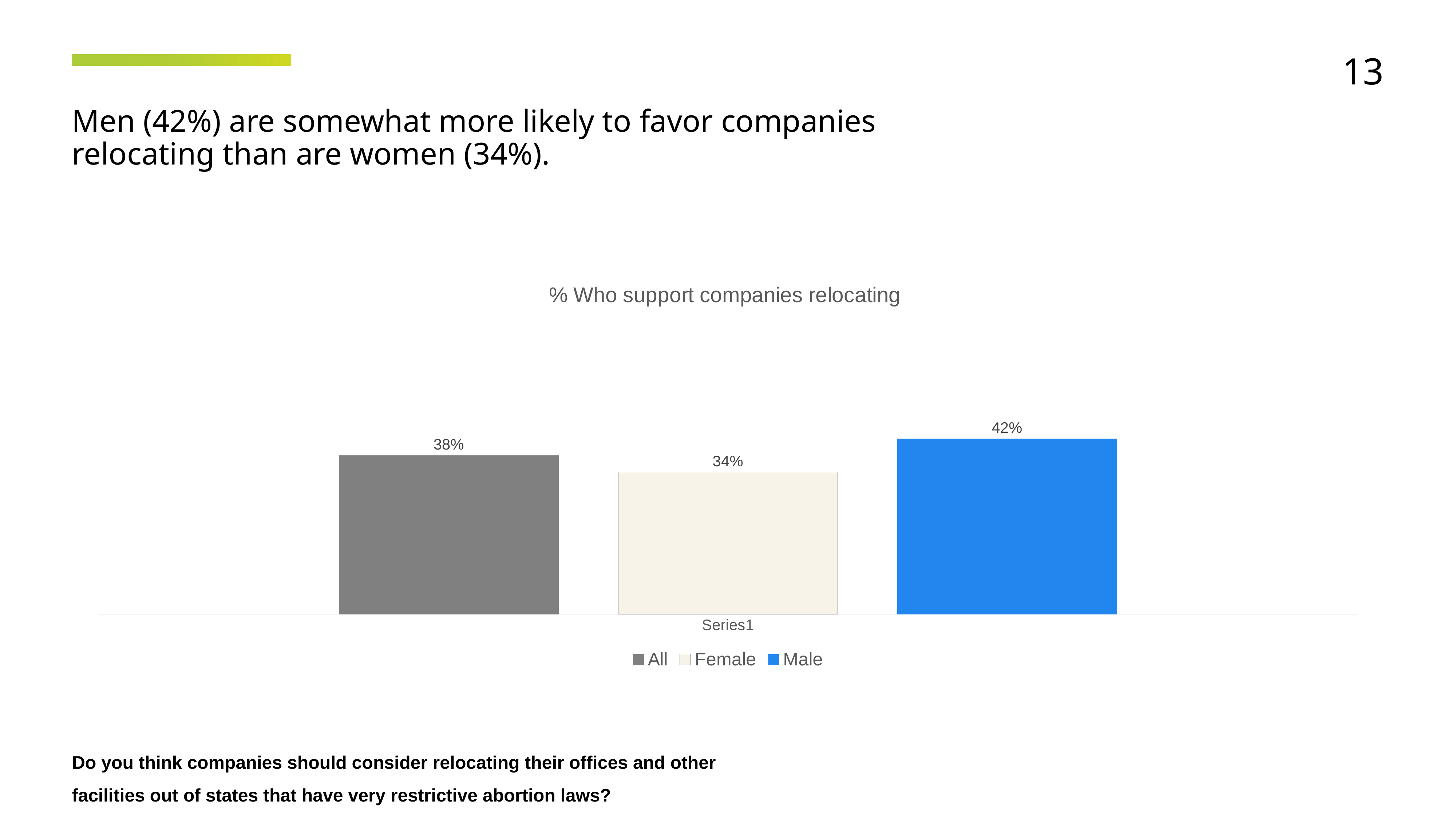
Which is larger, the value for All or the value for Female? All Which group has the lowest percentage supporting companies relocating? Female How many series does the legend list? 3 What is the value for Female in the chart? 34% What is the difference between the All and Female values? 4% What is the difference between the Male and Female values? 8% What is the title of the chart? % Who support companies relocating What is the value for Male in the chart? 42% What colour is the bar for Male? Blue What is the value for All in the chart? 38% What kind of chart is shown on the slide? Bar chart Which group has the highest percentage supporting companies relocating? Male